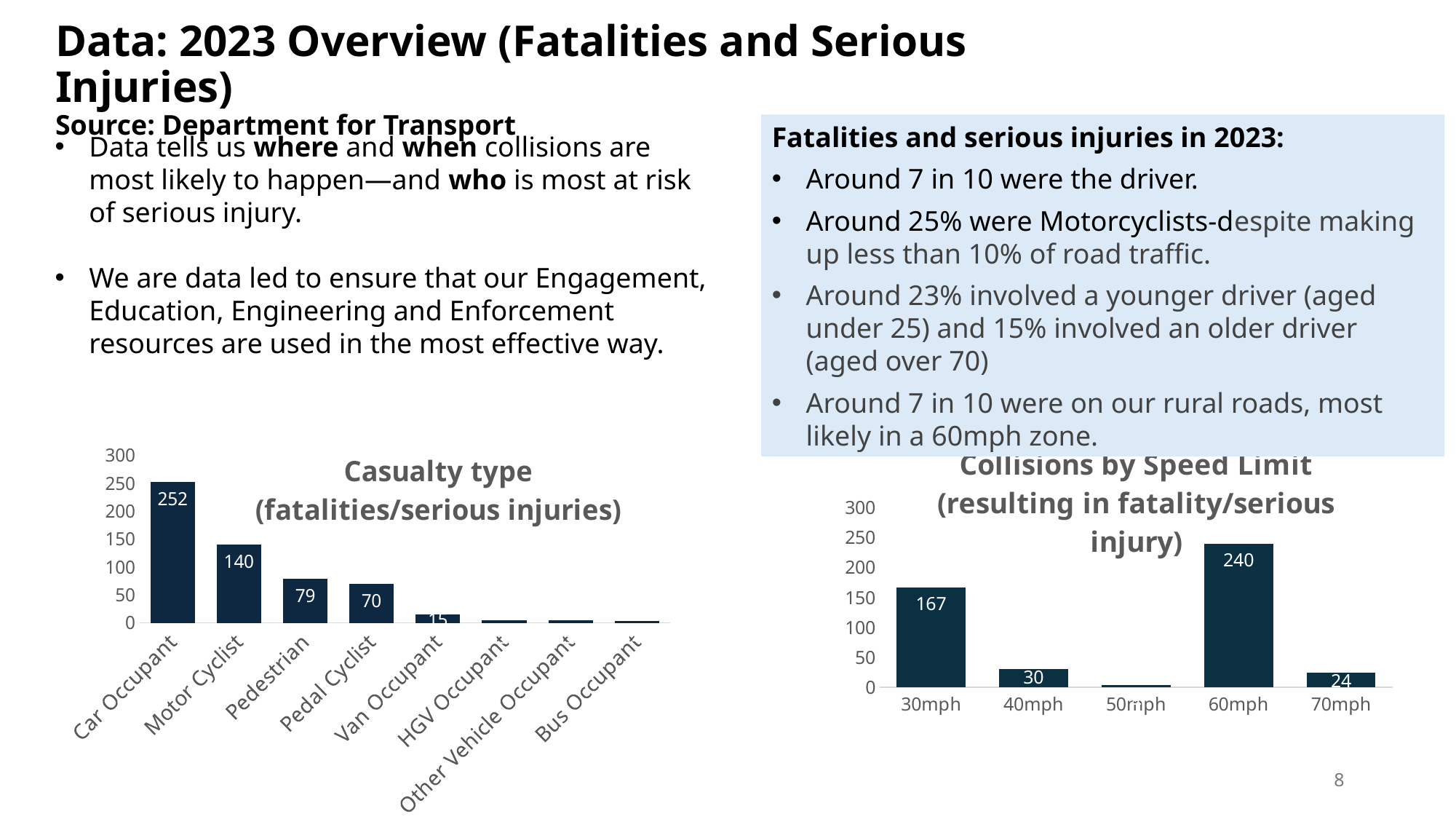
What kind of chart is the 'Collisions by Speed Limit' chart? Bar chart In the 'Casualty type' chart, what is the difference between the Pedestrian and Pedal Cyclist values? 9 In the 'Casualty type' chart, what is the value for Car Occupant? 252 In the 'Casualty type' chart, what is the value for Motor Cyclist? 140 In the 'Casualty type' chart, which casualty type has the highest value? Car Occupant In the 'Collisions by Speed Limit' chart, what is the difference between the 60mph and 30mph values? 73 In the 'Collisions by Speed Limit' chart, what is the value for 30mph? 167 In the 'Casualty type' chart, is the value for Van Occupant greater or less than 50? less In the 'Casualty type' chart, how many casualty types are shown on the x axis? 8 In the 'Collisions by Speed Limit' chart, what is the value for 60mph? 240 In the 'Collisions by Speed Limit' chart, which speed limit has the lowest value? 50mph In the 'Collisions by Speed Limit' chart, which is larger, the value for 40mph or the value for 70mph? 40mph